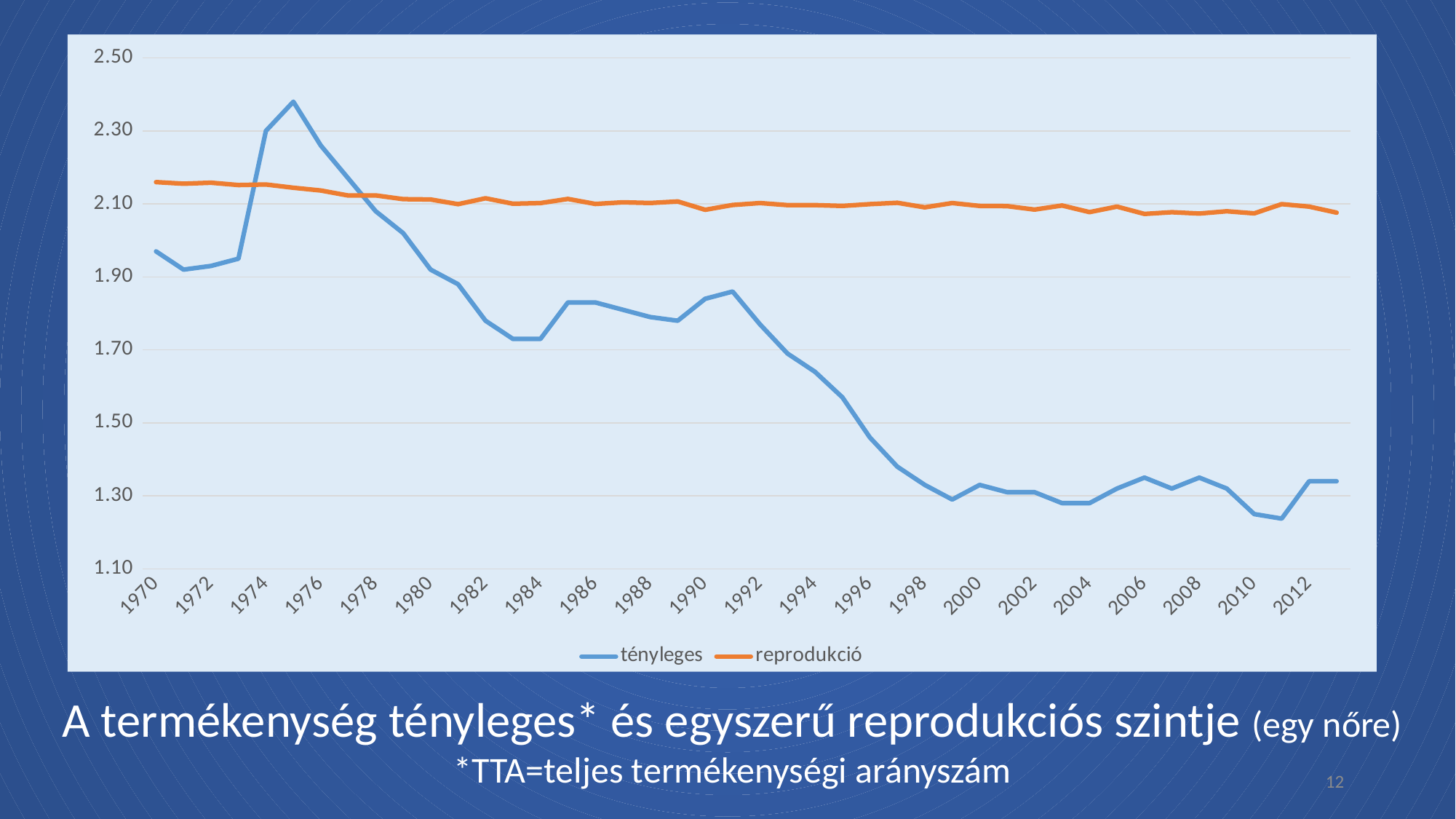
In 2000, which series has the higher value, tényleges or reprodukció? reprodukció Is the value for tényleges in 1970 greater or less than 1.90? greater How many series does the legend list? 2 Is the highest value reached by tényleges greater or less than 2.30? greater Does the tényleges series rise or fall between 1990 and 2000? fall What are the two series named in the legend? tényleges and reprodukció Is the value for tényleges in 1996 greater or less than 1.50? less What kind of chart is shown on the slide? line chart In 1976, which series has the higher value, tényleges or reprodukció? tényleges Which series is drawn in orange? reprodukció